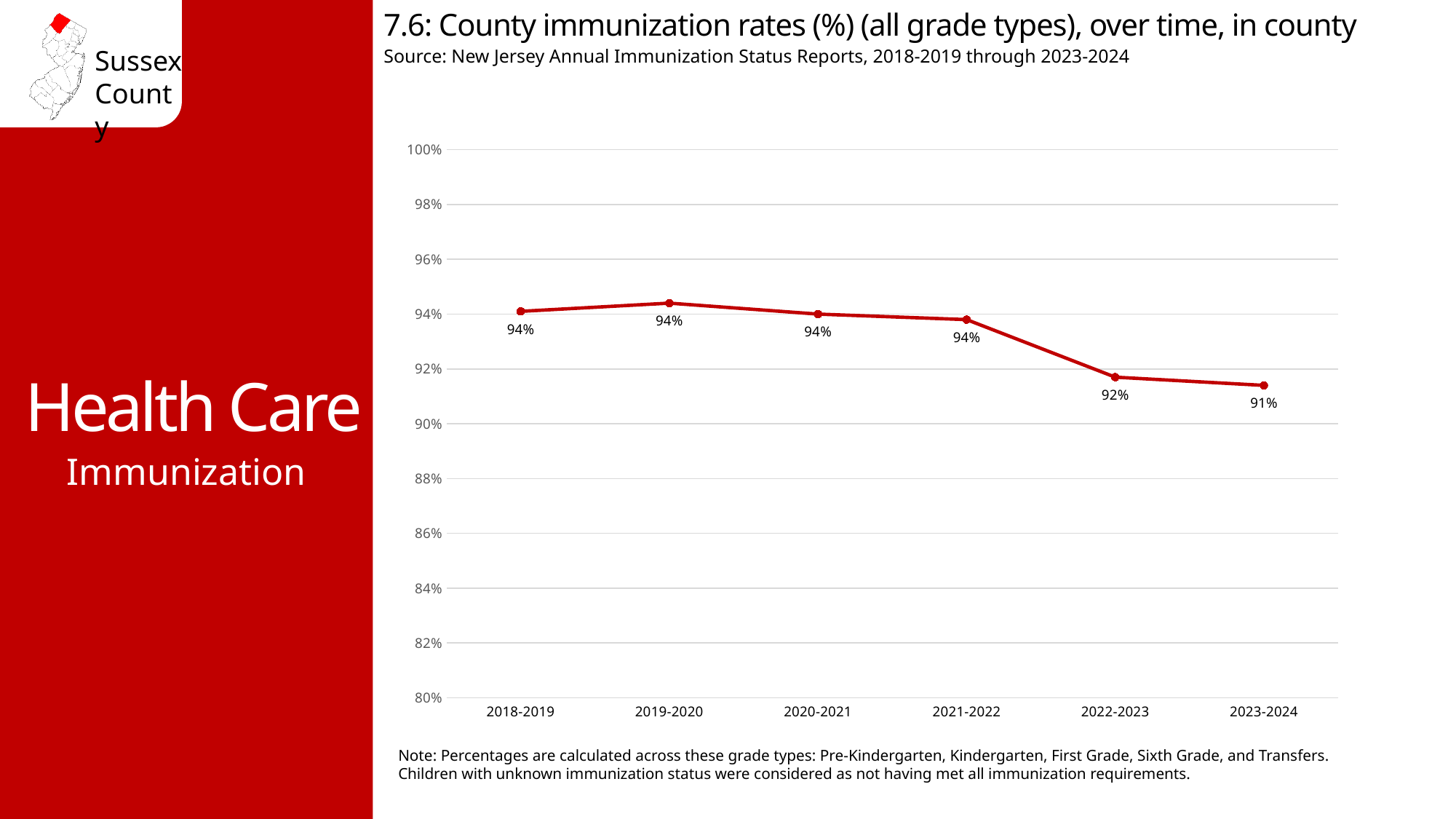
Which school year has the lowest immunization rate? 2023-2024 What is the county immunization rate for 2023-2024? 91% What is the county immunization rate for 2020-2021? 94% What is the county immunization rate for 2018-2019? 94% Is the value for 2018-2019 greater or less than 96%? less What is the difference between the immunization rate in 2018-2019 and in 2023-2024? 3 percentage points How many school years are plotted on the chart? 6 What kind of chart is shown on the slide? Line chart What is the county immunization rate for 2022-2023? 92% Do the immunization rates generally rise or fall from 2018-2019 to 2023-2024? Fall Which has a higher immunization rate, 2021-2022 or 2022-2023? 2021-2022 Is the value for 2023-2024 greater or less than 90%? greater